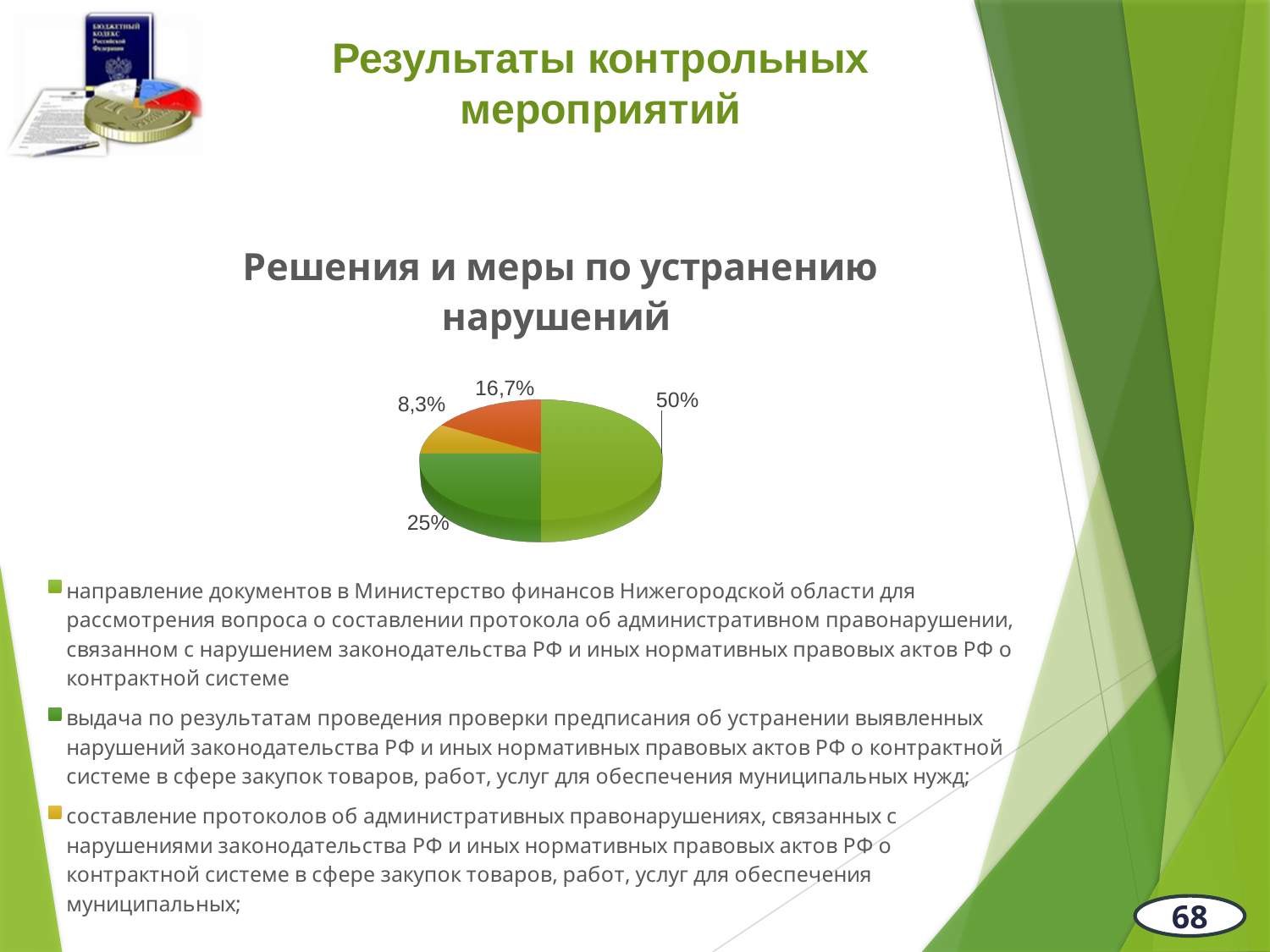
How many slices does the pie chart have? 4 What kind of chart is shown under the heading "Решения и меры по устранению нарушений"? pie chart What percentage is shown for the orange slice of the pie chart? 16,7% What percentage is shown for the yellow slice of the pie chart? 8,3% What share of the pie corresponds to the measure "выдача по результатам проведения проверки предписания об устранении выявленных нарушений" (dark green)? 25% What percentage is shown for the dark green slice of the pie chart? 25% By how many percentage points does the 50% slice exceed the 25% slice? 25 What percentage is shown for the light green slice of the pie chart? 50% What is the smallest slice of the pie chart? 8,3% What is the title of the chart on the slide? Решения и меры по устранению нарушений Which slice is larger, the orange one or the yellow one? the orange one (16,7%) What is the largest slice of the pie chart? 50%